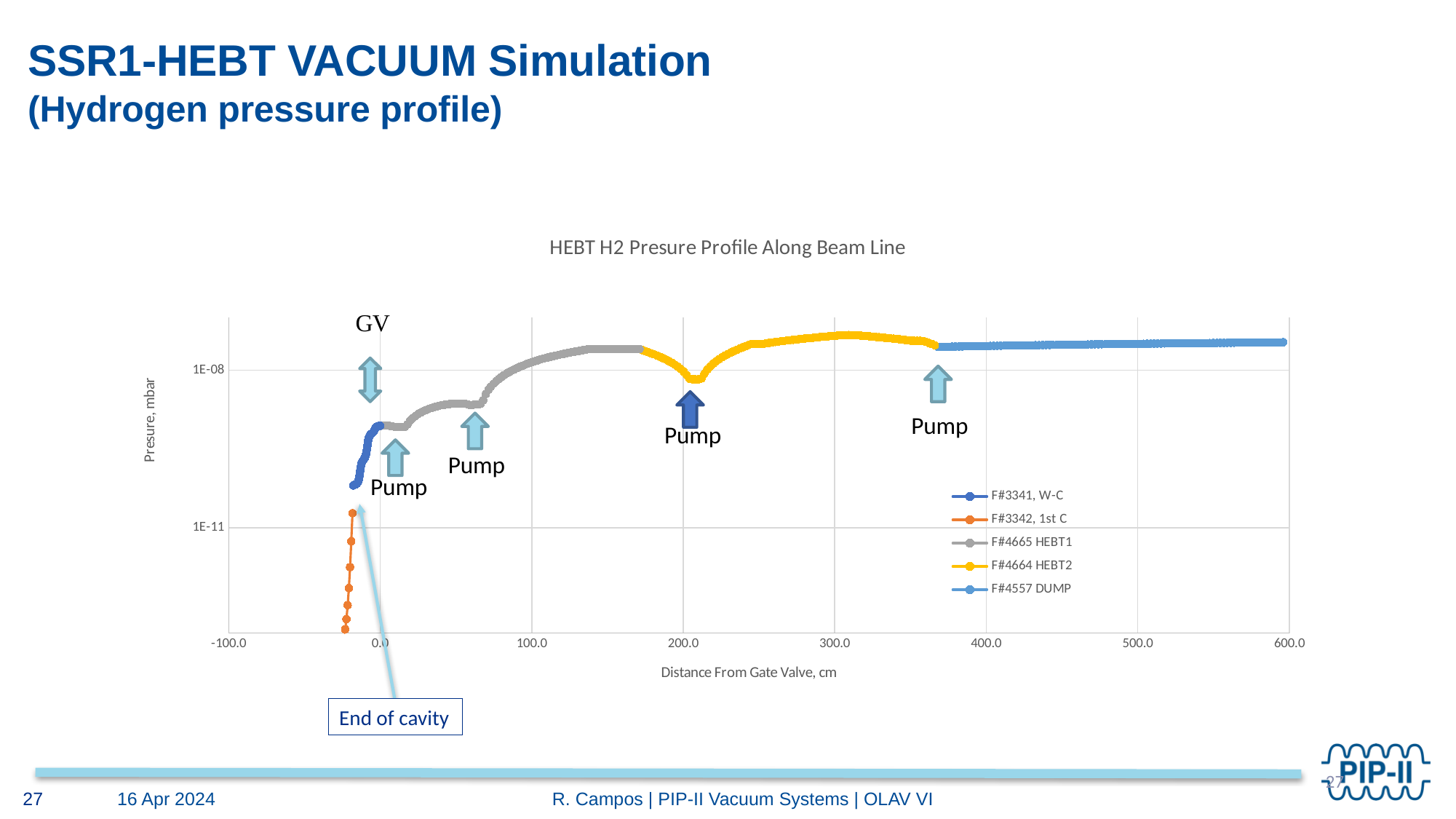
Are the values of the F#3342, 1st C series greater or less than 1E-08 mbar? less How many series does the legend list? 5 Which series has the lowest pressure values on the chart? F#3342, 1st C What colour is the F#4664 HEBT2 series plotted in? Yellow Which series has higher pressure values, F#4557 DUMP or F#3341, W-C? F#4557 DUMP What kind of chart is shown on the slide? Line chart What is the title of the chart? HEBT H2 Presure Profile Along Beam Line Does the pressure of the F#3341, W-C series rise or fall as distance increases? rise How many 'Pump' labels are marked on the chart? 4 Does the pressure of the F#3342, 1st C series rise or fall as distance increases? rise Are the values of the F#3341, W-C series greater or less than 1E-08 mbar? less Are the values of the F#4557 DUMP series greater or less than 1E-08 mbar? greater